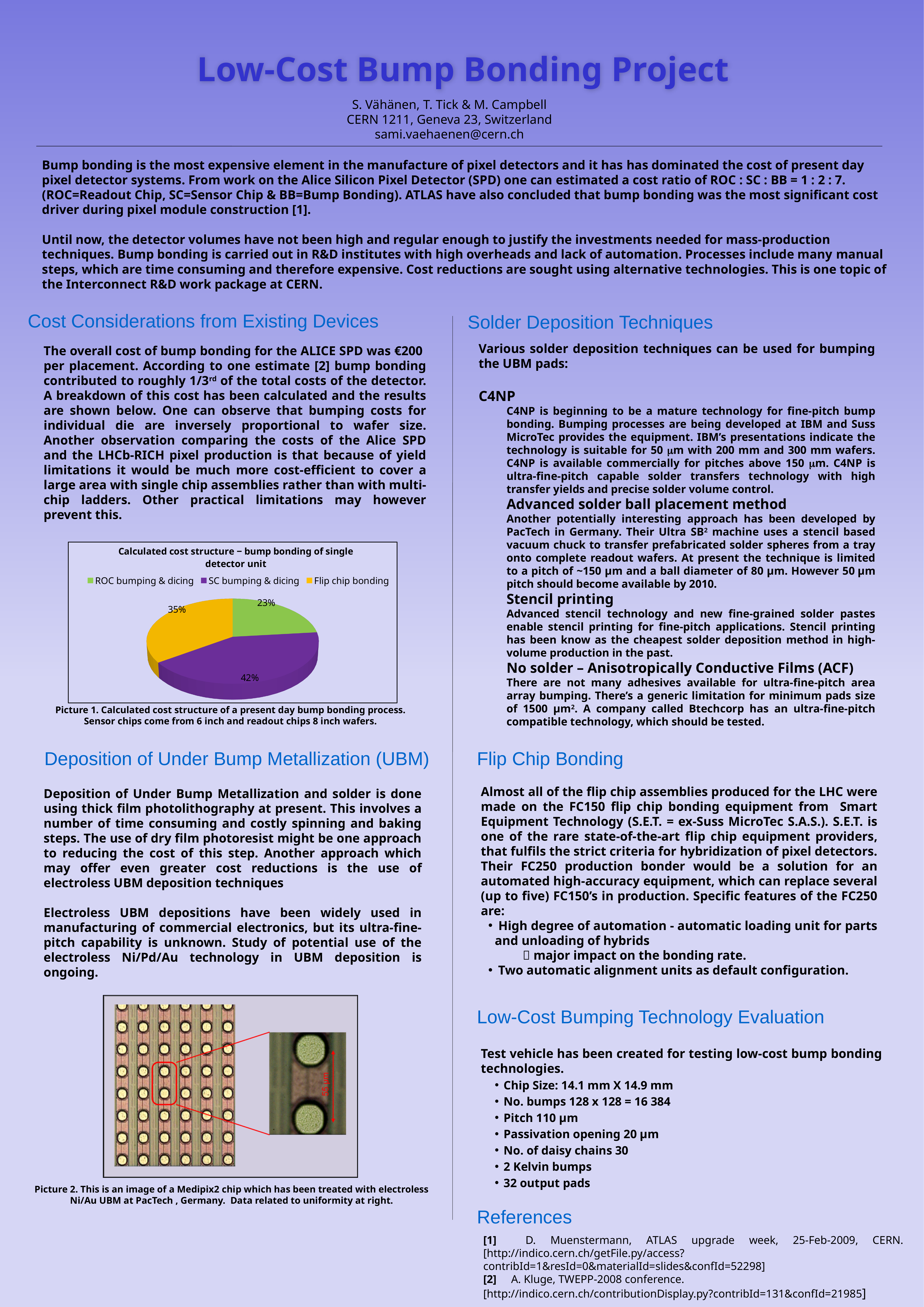
Which category has the smallest slice in the pie chart? ROC bumping & dicing What share of the cost does SC bumping & dicing account for in the pie chart? 42% What kind of chart is shown in Picture 1? pie chart What colour is the Flip chip bonding slice in the pie chart? yellow Which category has the largest slice in the pie chart? SC bumping & dicing How many entries does the legend of the pie chart list? 3 What is the title of the pie chart? Calculated cost structure – bump bonding of single detector unit How many slices does the pie chart have? 3 What share of the cost does Flip chip bonding account for in the pie chart? 35% Which is larger in the pie chart, Flip chip bonding or ROC bumping & dicing? Flip chip bonding What share of the cost does ROC bumping & dicing account for in the pie chart? 23% What is the difference in percentage points between SC bumping & dicing and ROC bumping & dicing in the pie chart? 19